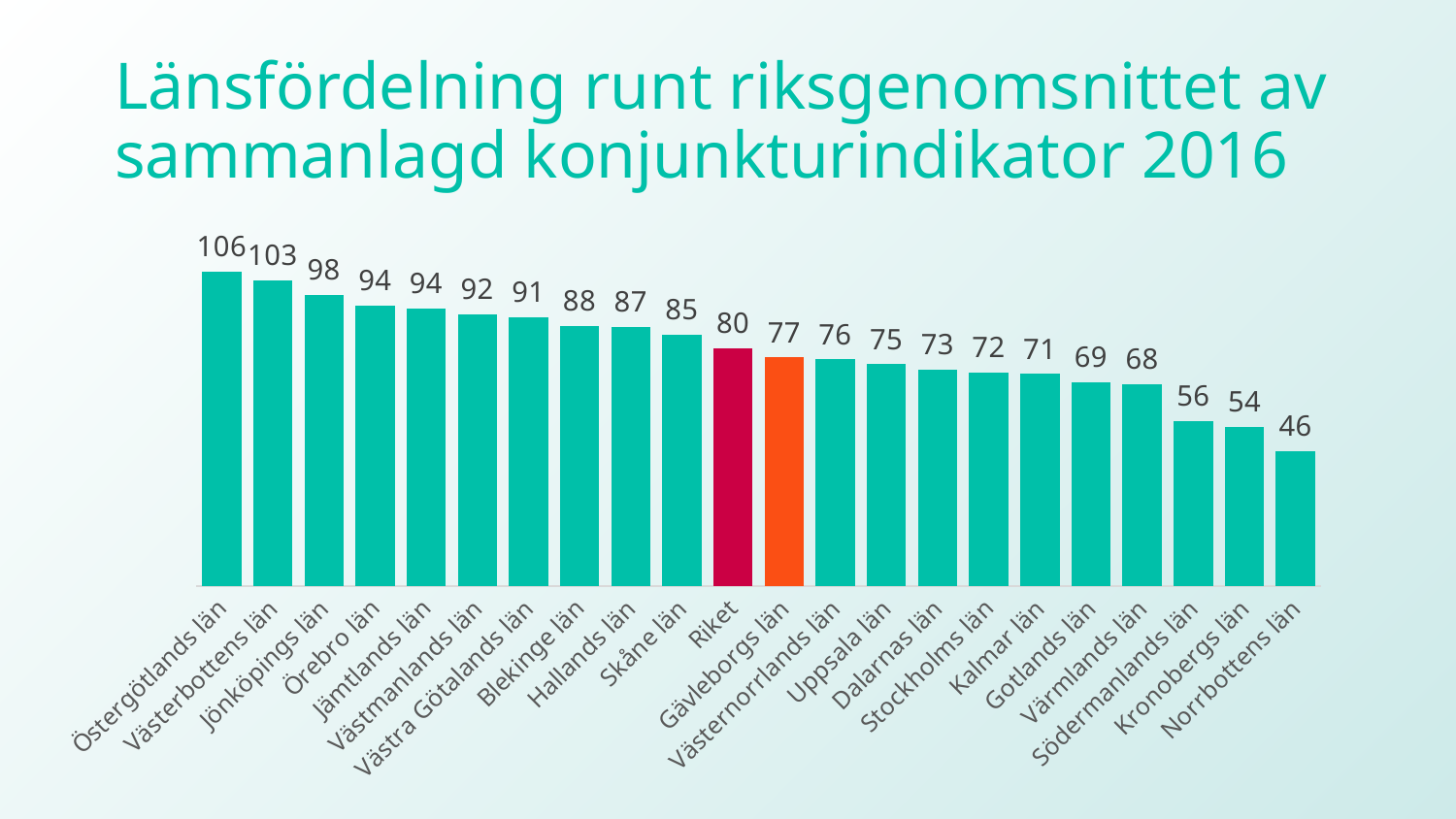
How many bars are shown in the chart? 22 Which county has the highest value? Östergötlands län Which county has the lowest value? Norrbottens län What is the difference between the values for Östergötlands län and Norrbottens län? 60 What kind of chart is shown on the slide? Bar chart Do the values rise or fall from left to right along the x axis? Fall What is the value for Riket? 80 Which bar is coloured dark red? Riket What is the value for Stockholms län? 72 Which is larger, the value for Jönköpings län or the value for Uppsala län? Jönköpings län What is the value for Gävleborgs län? 77 What is the difference between the values for Skåne län and Riket? 5